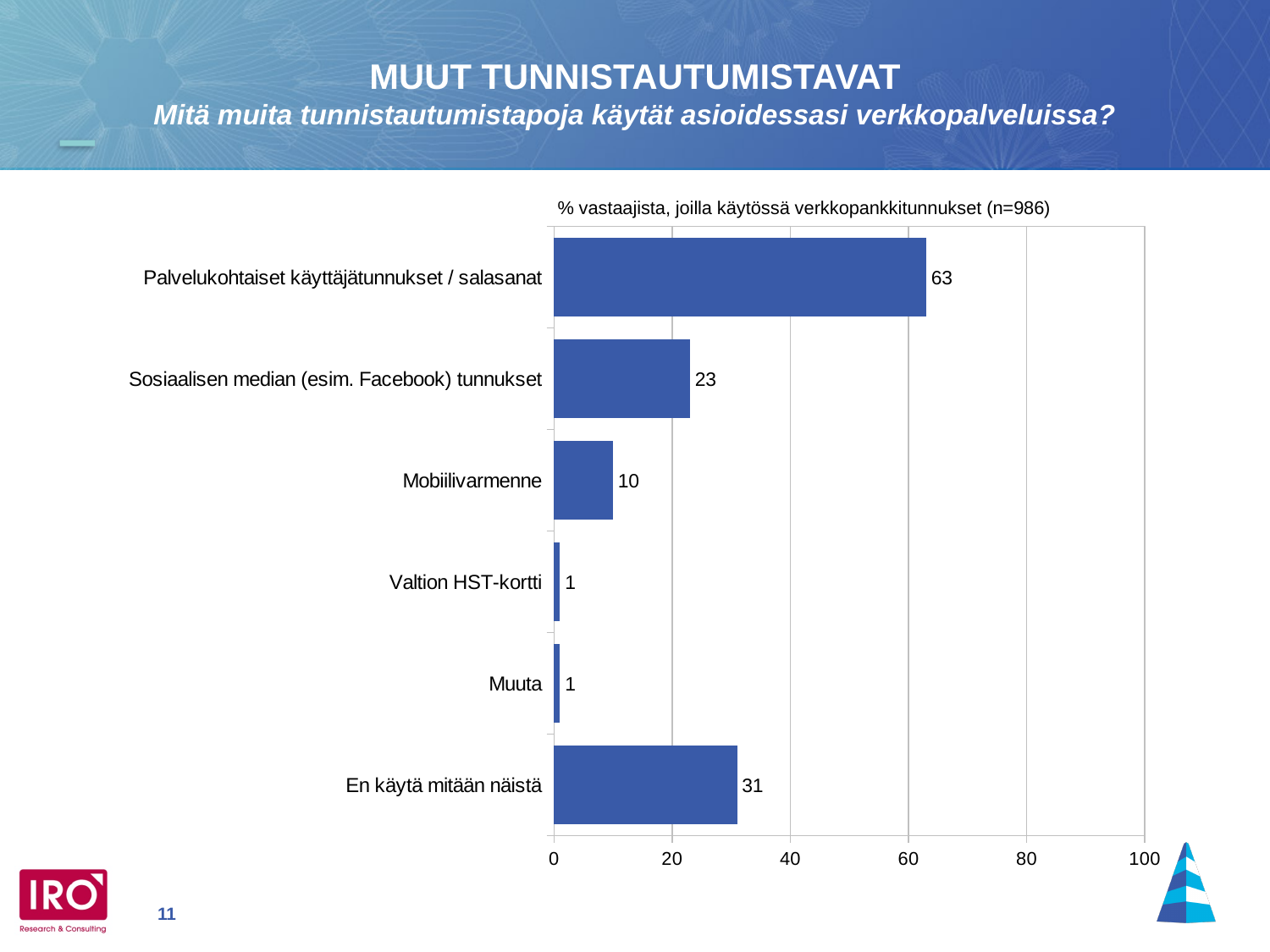
What is the difference between the values for Palvelukohtaiset käyttäjätunnukset / salasanat and En käytä mitään näistä? 32 Which category has the highest value? Palvelukohtaiset käyttäjätunnukset / salasanat What is the difference between the values for Sosiaalisen median (esim. Facebook) tunnukset and Mobiilivarmenne? 13 What is the value for Palvelukohtaiset käyttäjätunnukset / salasanat? 63 Which is larger, the value for En käytä mitään näistä or the value for Sosiaalisen median (esim. Facebook) tunnukset? En käytä mitään näistä Is the value for Palvelukohtaiset käyttäjätunnukset / salasanat greater or less than 60? greater What is the value for Sosiaalisen median (esim. Facebook) tunnukset? 23 What is the title shown above the chart? % vastaajista, joilla käytössä verkkopankkitunnukset (n=986) How many categories are shown in the chart? 6 What kind of chart is shown on the slide? bar chart What is the value for En käytä mitään näistä? 31 What is the value for Mobiilivarmenne? 10